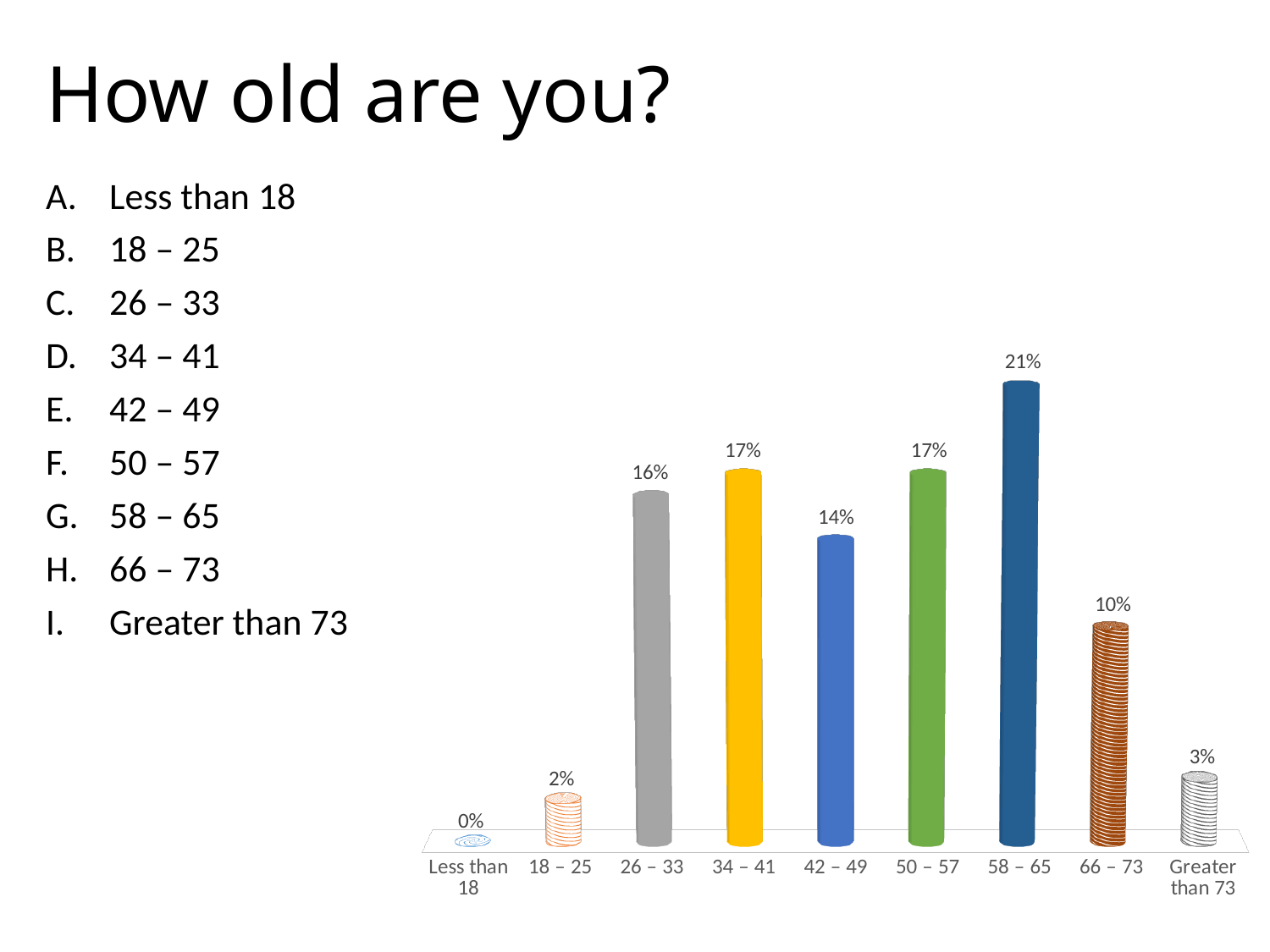
What percentage of respondents are aged 42 – 49? 14% What is the combined percentage for the 18 – 25 and Greater than 73 groups? 5% What kind of chart is shown on the slide? Bar chart How many age categories are shown on the chart? 9 Which is larger, the percentage for 34 – 41 or for 42 – 49? 34 – 41 Which age group has the lowest percentage? Less than 18 What percentage of respondents are aged 58 – 65? 21% What percentage of respondents are aged 26 – 33? 16% Which age group has the highest percentage? 58 – 65 What is the difference in percentage points between the 58 – 65 group and the 66 – 73 group? 11 Which two age groups both have a value of 17%? 34 – 41 and 50 – 57 What percentage of respondents are Greater than 73? 3%